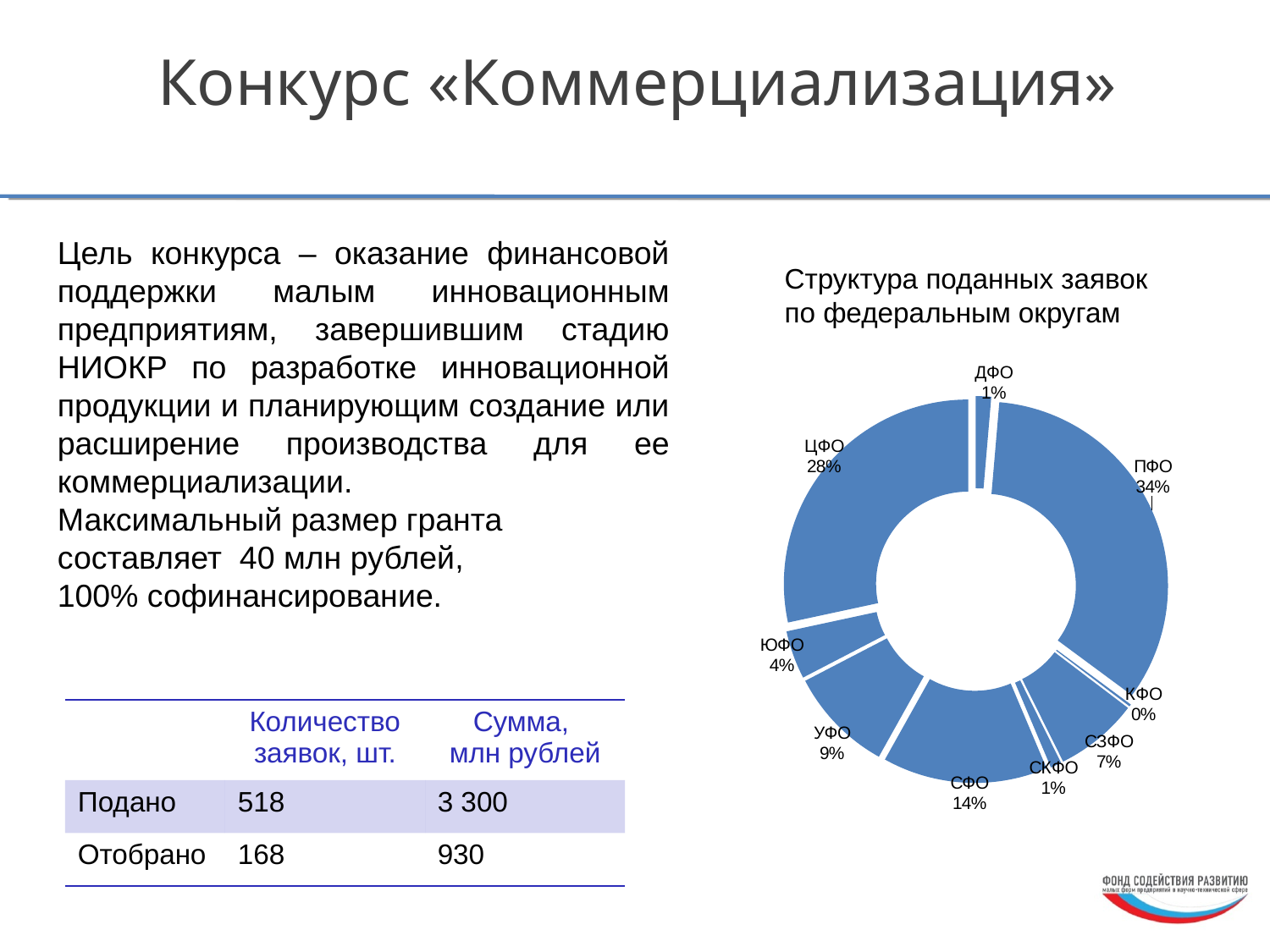
Which has a larger share of submitted applications, СФО or УФО? СФО What share of submitted applications does СЗФО account for? 7% Which federal district has the largest share of submitted applications? ПФО How many federal districts are shown in the chart? 9 What kind of chart is used to show the structure of submitted applications by federal district? doughnut (pie) chart What is the difference in percentage points between the shares of ПФО and ЦФО? 6 What share of submitted applications does ЦФО account for? 28% What share of submitted applications does СФО account for? 14% Which federal district has the smallest share of submitted applications? КФО What share of submitted applications does УФО account for? 9% What share of submitted applications does ПФО account for in the chart 'Структура поданных заявок по федеральным округам'? 34% What is the title of the chart on the slide? Структура поданных заявок по федеральным округам